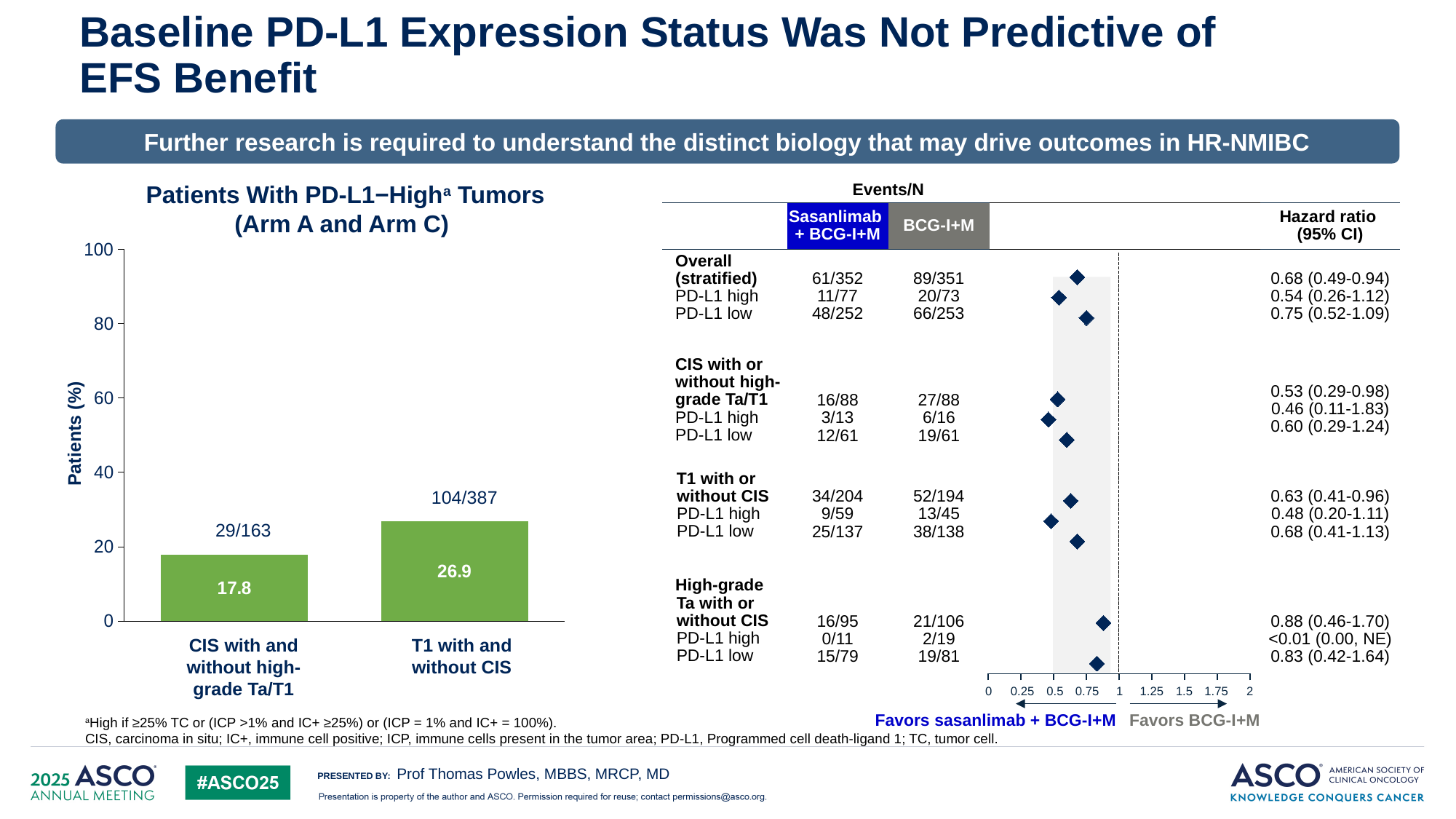
In the bar chart on the left, how many categories are plotted? 2 In the bar chart titled 'Patients With PD-L1−High Tumors (Arm A and Arm C)', what percentage of patients is shown for 'T1 with and without CIS'? 26.9 In the bar chart on the left, is the value for 'CIS with and without high-grade Ta/T1' greater or less than 20? less In the bar chart on the left, what fraction label is printed above the 'CIS with and without high-grade Ta/T1' bar? 29/163 In the bar chart on the left, which category has the higher percentage of patients? T1 with and without CIS What kind of chart is shown on the left side of the slide? Bar chart In the forest plot on the right, what is the hazard ratio (95% CI) for PD-L1 high patients in the 'High-grade Ta with or without CIS' subgroup? <0.01 (0.00, NE) In the bar chart on the left, what is the difference in percentage points between 'T1 with and without CIS' and 'CIS with and without high-grade Ta/T1'? 9.1 In the forest plot on the right, what is the Events/N for Sasanlimab + BCG-I+M in the Overall (stratified) row? 61/352 In the bar chart titled 'Patients With PD-L1−High Tumors (Arm A and Arm C)', what percentage of patients is shown for 'CIS with and without high-grade Ta/T1'? 17.8 In the bar chart on the left, what fraction label is printed above the 'T1 with and without CIS' bar? 104/387 In the forest plot on the right, what is the hazard ratio (95% CI) for the Overall (stratified) population? 0.68 (0.49-0.94)